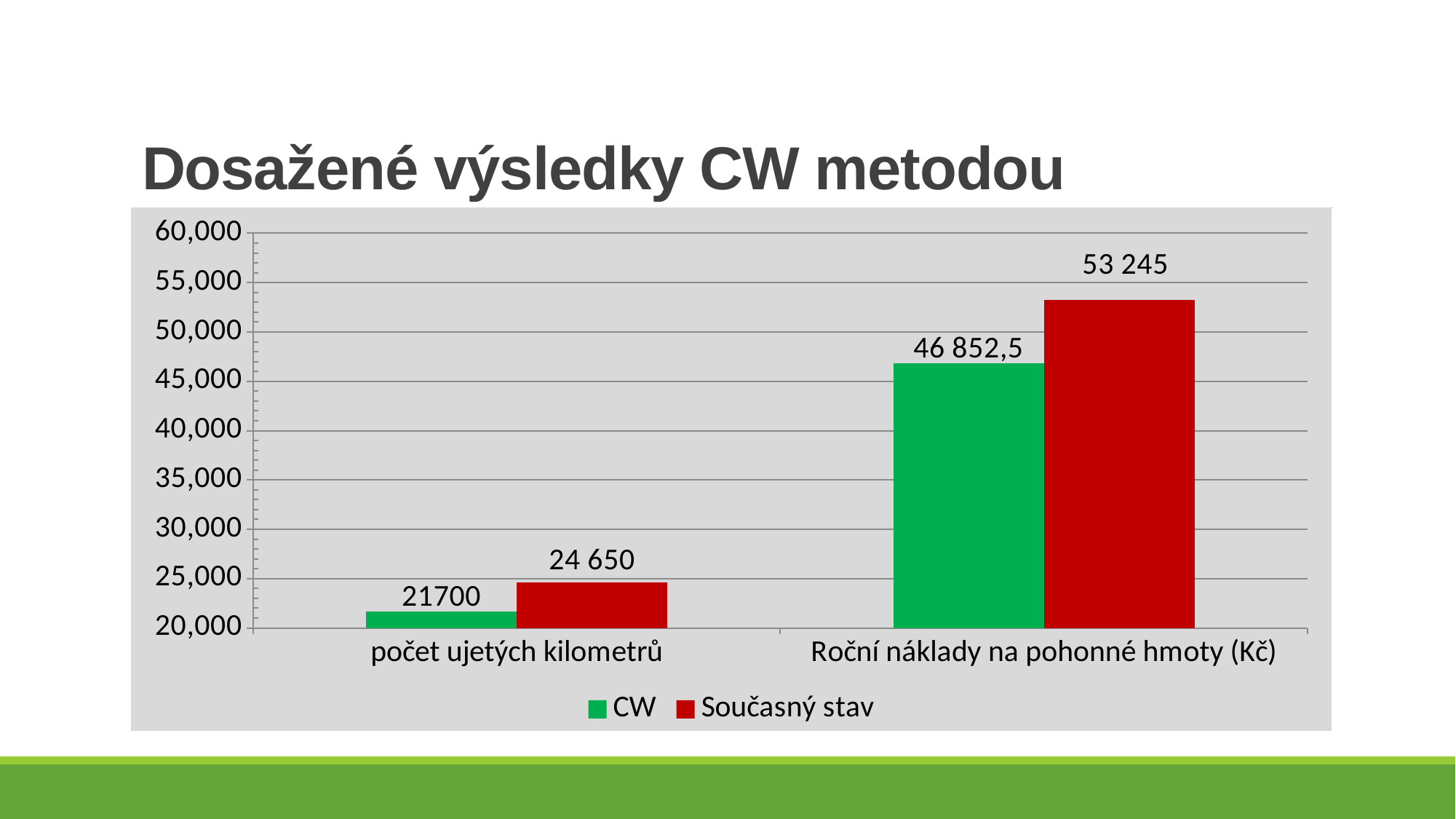
Which bar in the chart is the shortest? CW for počet ujetých kilometrů Which series has the higher value for Roční náklady na pohonné hmoty (Kč), CW or Současný stav? Současný stav How many series does the legend list? 2 What is the CW value for Roční náklady na pohonné hmoty (Kč)? 46 852,5 Which bar in the chart is the tallest? Současný stav for Roční náklady na pohonné hmoty (Kč) What is the CW value for počet ujetých kilometrů? 21700 What is the Současný stav value for počet ujetých kilometrů? 24 650 What is the Současný stav value for Roční náklady na pohonné hmoty (Kč)? 53 245 What type of chart is shown on the slide? Bar chart How many categories are shown on the x axis? 2 What is the difference between the Současný stav and CW values for Roční náklady na pohonné hmoty (Kč)? 6 392,5 What is the difference between the Současný stav and CW values for počet ujetých kilometrů? 2 950